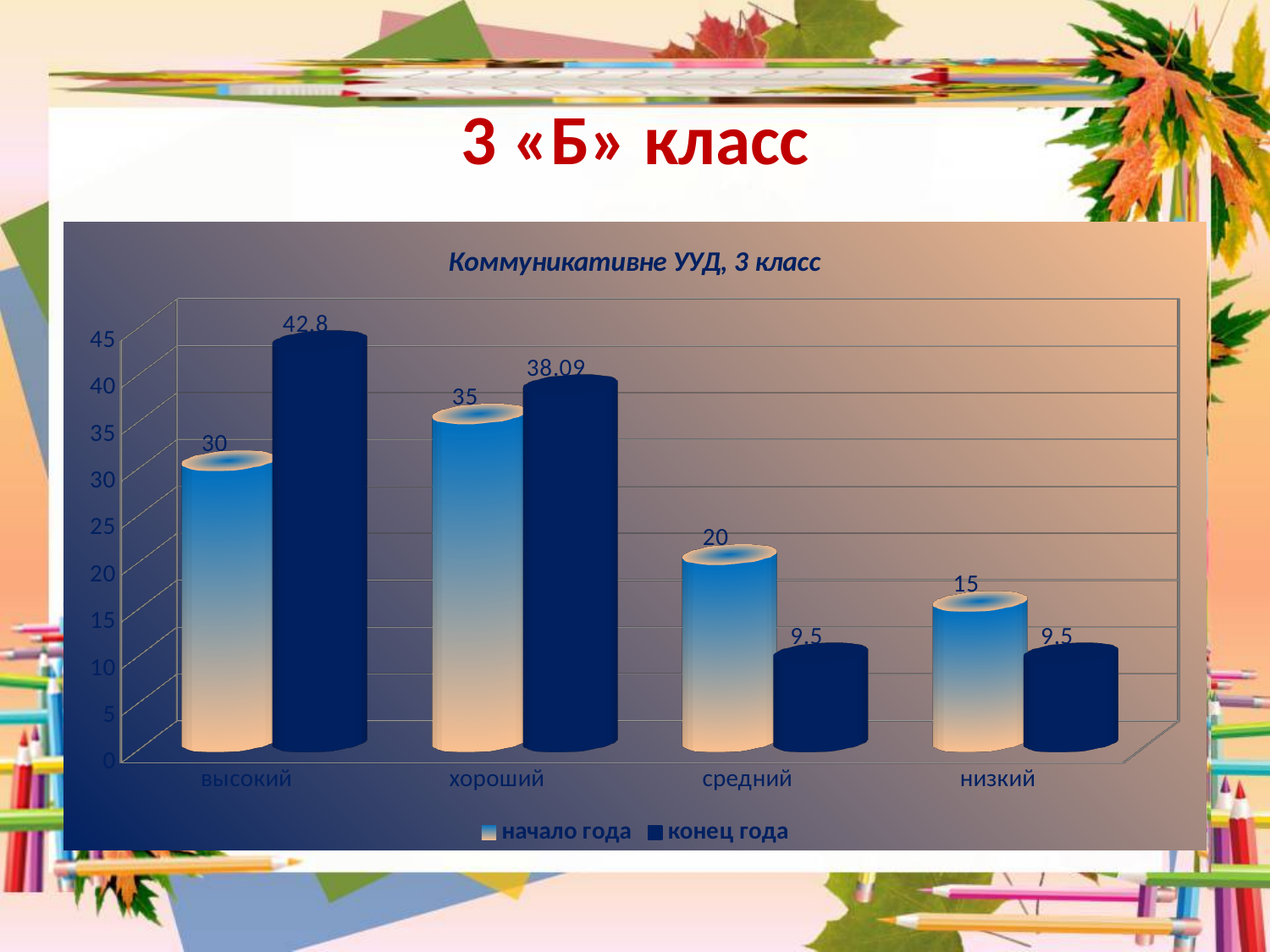
What is the difference between the "конец года" and "начало года" values for "высокий"? 12.8 What is the title of the chart? Коммуникативне УУД, 3 класс What is the value for "низкий" in the "начало года" series? 15 How many series does the legend list? 2 What is the value for "хороший" in the "начало года" series? 35 Which is larger for "средний": the "начало года" value or the "конец года" value? начало года How many categories are shown on the x axis? 4 Which category has the lowest value in the "начало года" series? низкий Which category has the highest value in the "конец года" series? высокий What kind of chart is shown on the slide? bar chart What is the value for "средний" in the "конец года" series? 9.5 What is the value for "высокий" in the "конец года" series? 42.8